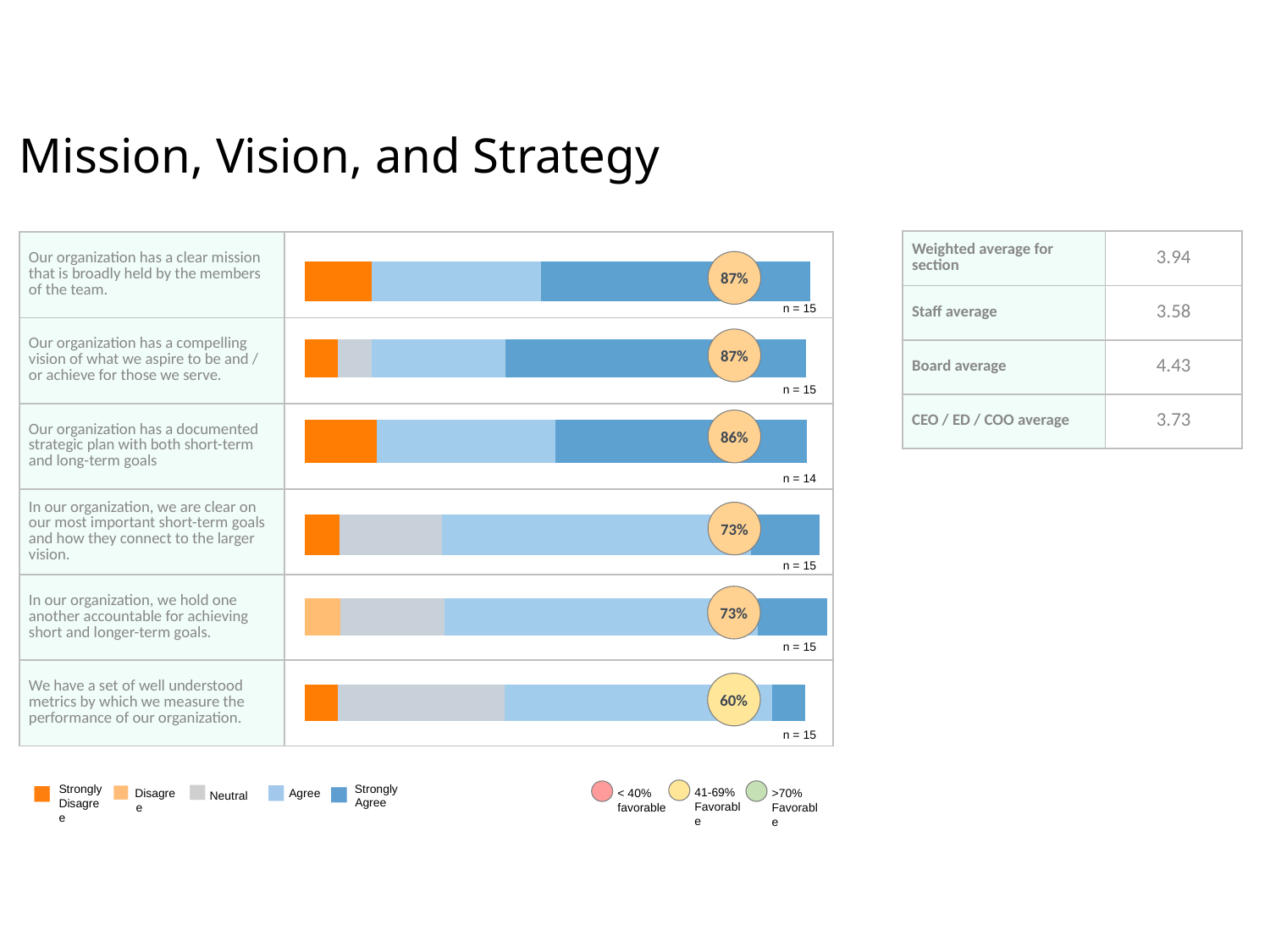
How many response categories does the legend list for the bars? 5 What is the n value for the statement "Our organization has a documented strategic plan with both short-term and long-term goals"? n = 14 Which statement has the lowest favorable percentage? We have a set of well understood metrics by which we measure the performance of our organization. Which has a higher favorable percentage: the compelling vision statement or the accountability for short and longer-term goals statement? The compelling vision statement (87%) What favorable percentage is shown for the statement "Our organization has a documented strategic plan with both short-term and long-term goals"? 86% Which legend category is shown in dark orange? Strongly Disagree Which favorability band does the 60% circle fall into according to the legend? 41-69% Favorable How many statements (bars) are shown on the slide? 6 What is the difference in favorable percentage between the clear mission statement (87%) and the well understood metrics statement (60%)? 27% What favorable percentage is shown for the statement "We have a set of well understood metrics by which we measure the performance of our organization"? 60% What type of chart is used to show the responses for each statement? Stacked horizontal bar chart What favorable percentage is shown for the statement "Our organization has a clear mission that is broadly held by the members of the team"? 87%